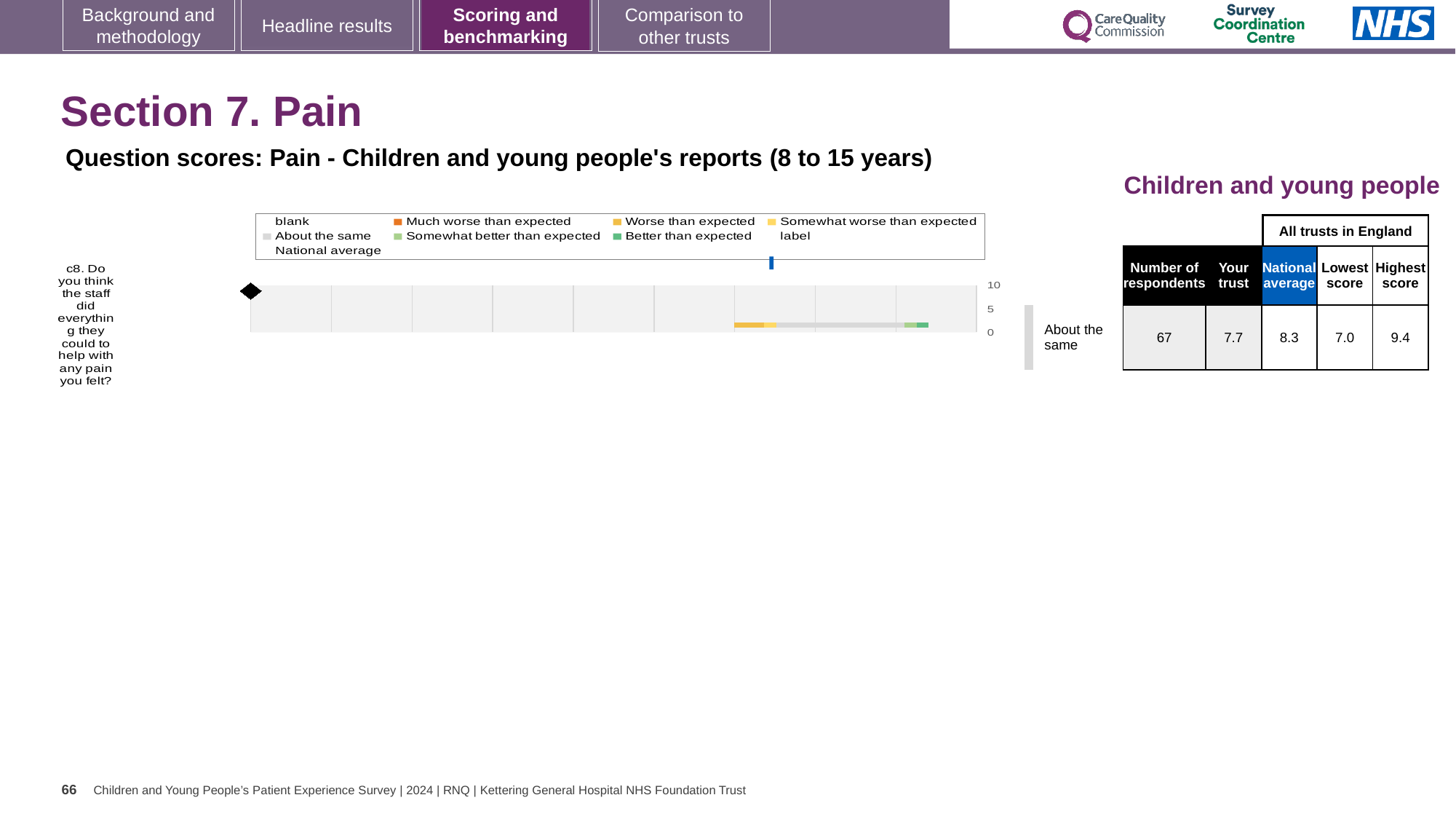
Which benchmarking category is the trust's result for question c8 placed in? About the same Which is larger for question c8: the 'Your trust' score or the national average? National average What is the national average score for question c8? 8.3 What kind of chart is shown on the slide for question c8? bar chart Is the national average marker for question c8 positioned at a value greater or less than 5 on the axis? greater How many survey questions are plotted in the chart? 1 What is the lowest score among all trusts in England for question c8? 7.0 What is the 'Your trust' score for question c8 (Do you think the staff did everything they could to help with any pain you felt?)? 7.7 What is the difference between the highest score and the lowest score for question c8? 2.4 What is the highest value shown on the chart's axis? 10 What is the highest score among all trusts in England for question c8? 9.4 How many respondents answered question c8? 67